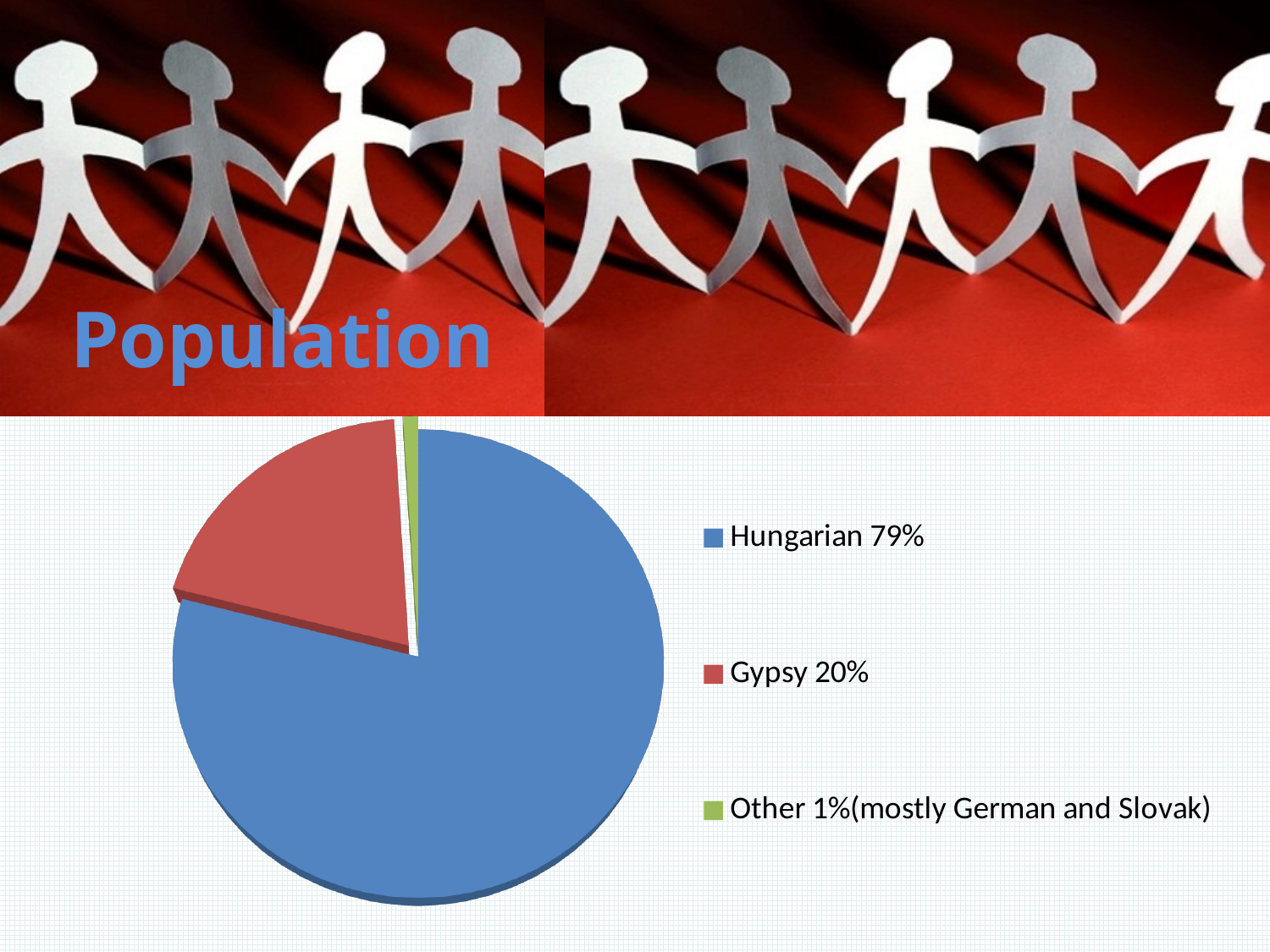
What share of the population is Hungarian according to the legend? 79% What share of the population is Gypsy according to the legend? 20% How many entries does the legend list? 3 What kind of chart is shown on the slide? pie chart According to the legend, what groups make up the Other category? mostly German and Slovak Which group has the largest slice of the pie? Hungarian How many slices does the pie chart have? 3 What share of the population is listed as Other? 1% Which group has the smallest slice of the pie? Other What is the difference in percentage points between the Hungarian and Gypsy shares? 59 Which is larger, the Gypsy share or the Other share? Gypsy Which colour represents the Gypsy slice? red